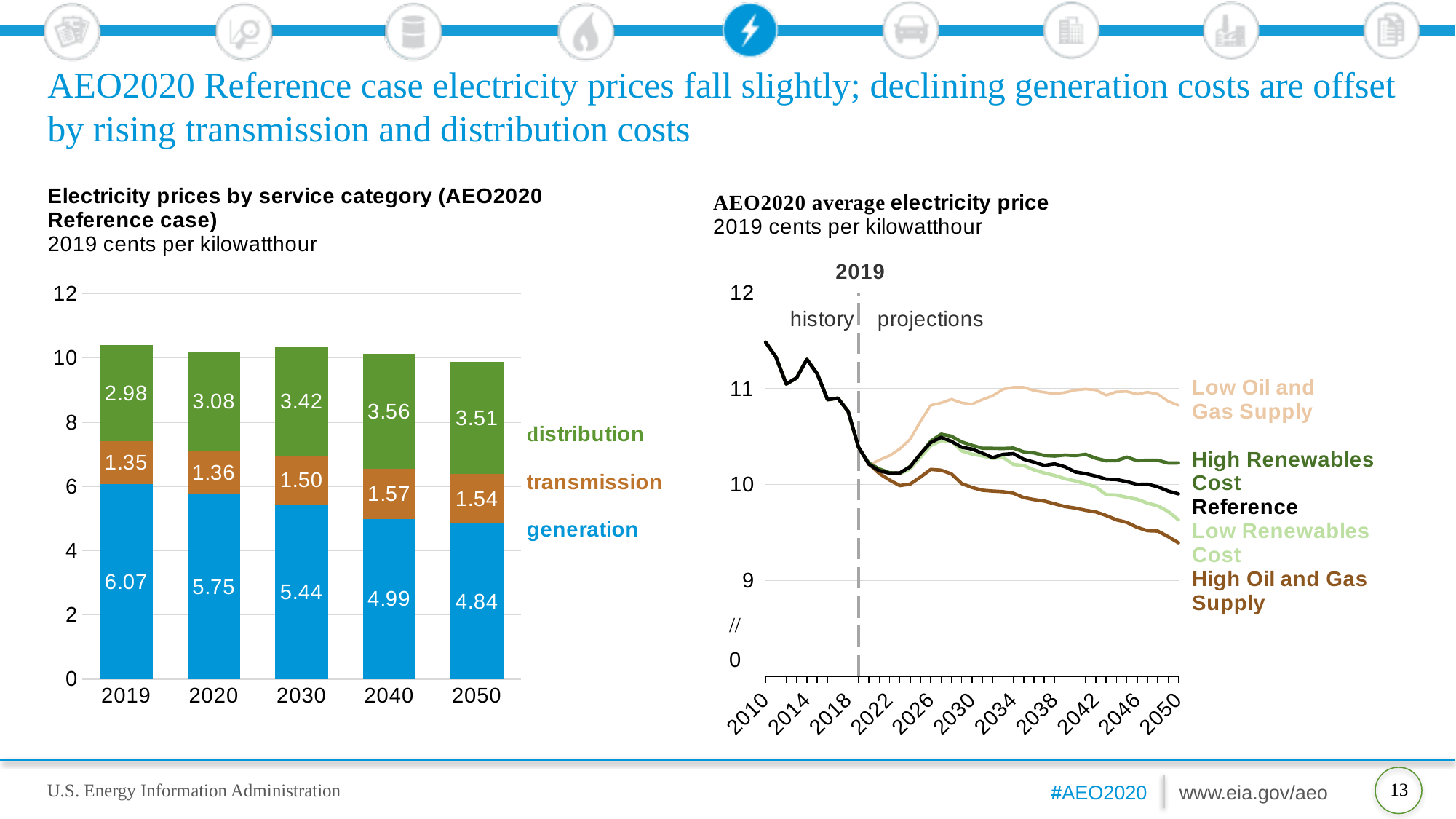
In the 'Electricity prices by service category' chart, which year has the lowest generation value? 2050 In the 'Electricity prices by service category' chart, what is the difference between the generation values for 2019 and 2050? 1.23 In the 'Electricity prices by service category' chart, is the distribution value larger in 2030 or 2040? 2040 In the 'Electricity prices by service category' chart, what is the generation value for 2019? 6.07 In the 'Electricity prices by service category' chart, which year has the highest generation value? 2019 In the 'Electricity prices by service category' chart, does the generation value rise or fall from 2019 to 2050? fall In the 'Electricity prices by service category' chart, what is the distribution value for 2050? 3.51 In the 'Electricity prices by service category' chart, what is the transmission value for 2040? 1.57 In the 'AEO2020 average electricity price' chart, which scenario has the highest price in 2050? Low Oil and Gas Supply In the 'AEO2020 average electricity price' chart, how many scenario lines are labeled? 5 In the 'Electricity prices by service category' chart, how many years are shown on the x axis? 5 In the 'Electricity prices by service category' chart, what is the total of the stacked bar for 2019? 10.40